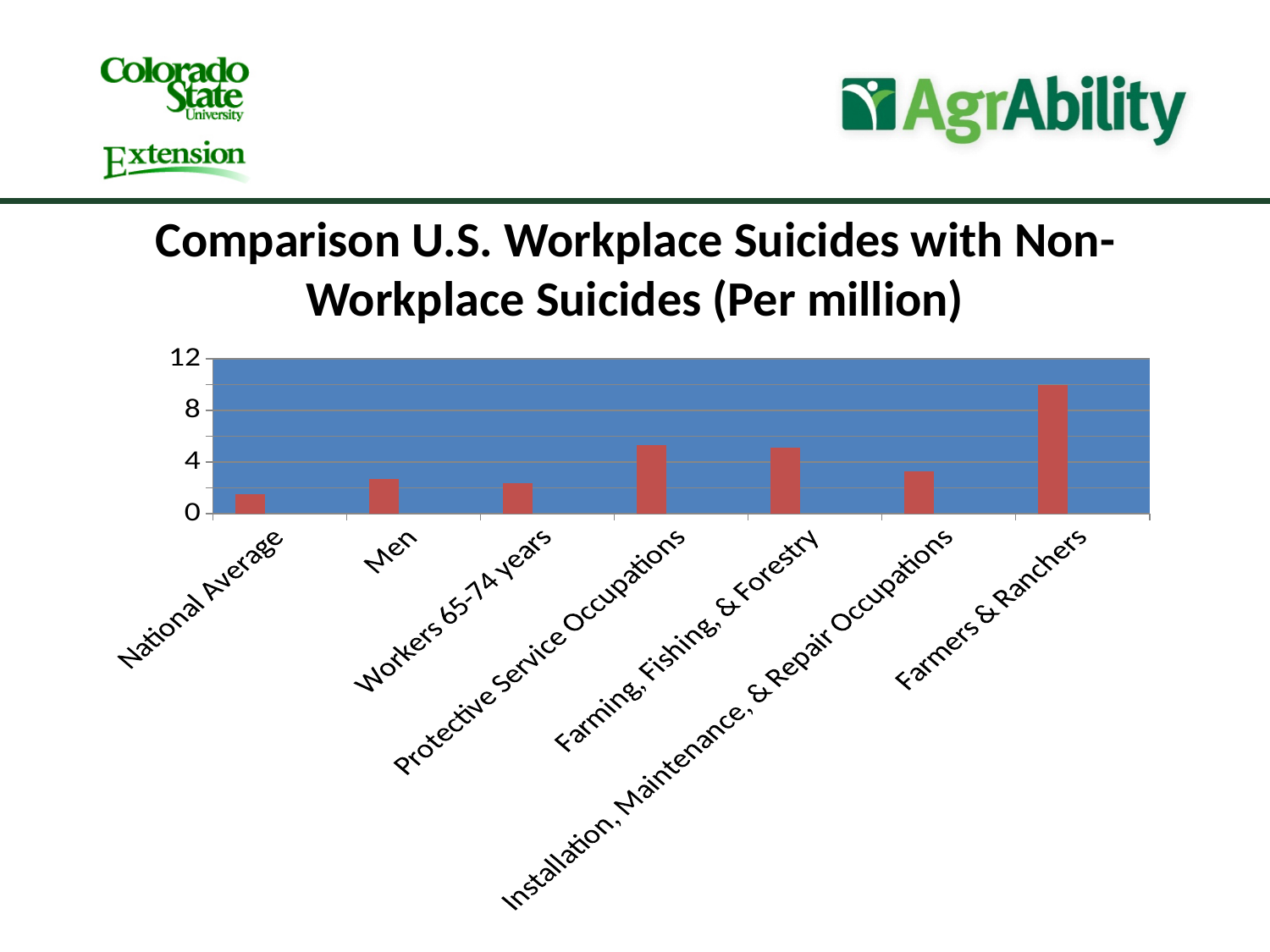
Which category has the lowest value in the chart? National Average Is the value for National Average greater or less than 4? less Which category has the highest value in the chart? Farmers & Ranchers Which is larger, the value for Farmers & Ranchers or the value for Farming, Fishing, & Forestry? Farmers & Ranchers Is the value for Farmers & Ranchers greater or less than 8? greater Is the value for Protective Service Occupations greater or less than 4? greater How many categories are shown on the x axis of the chart? 7 What is the title of the chart? Comparison U.S. Workplace Suicides with Non-Workplace Suicides (Per million) Which is larger, the value for Protective Service Occupations or the value for Workers 65-74 years? Protective Service Occupations What kind of chart is shown on the slide? Bar chart